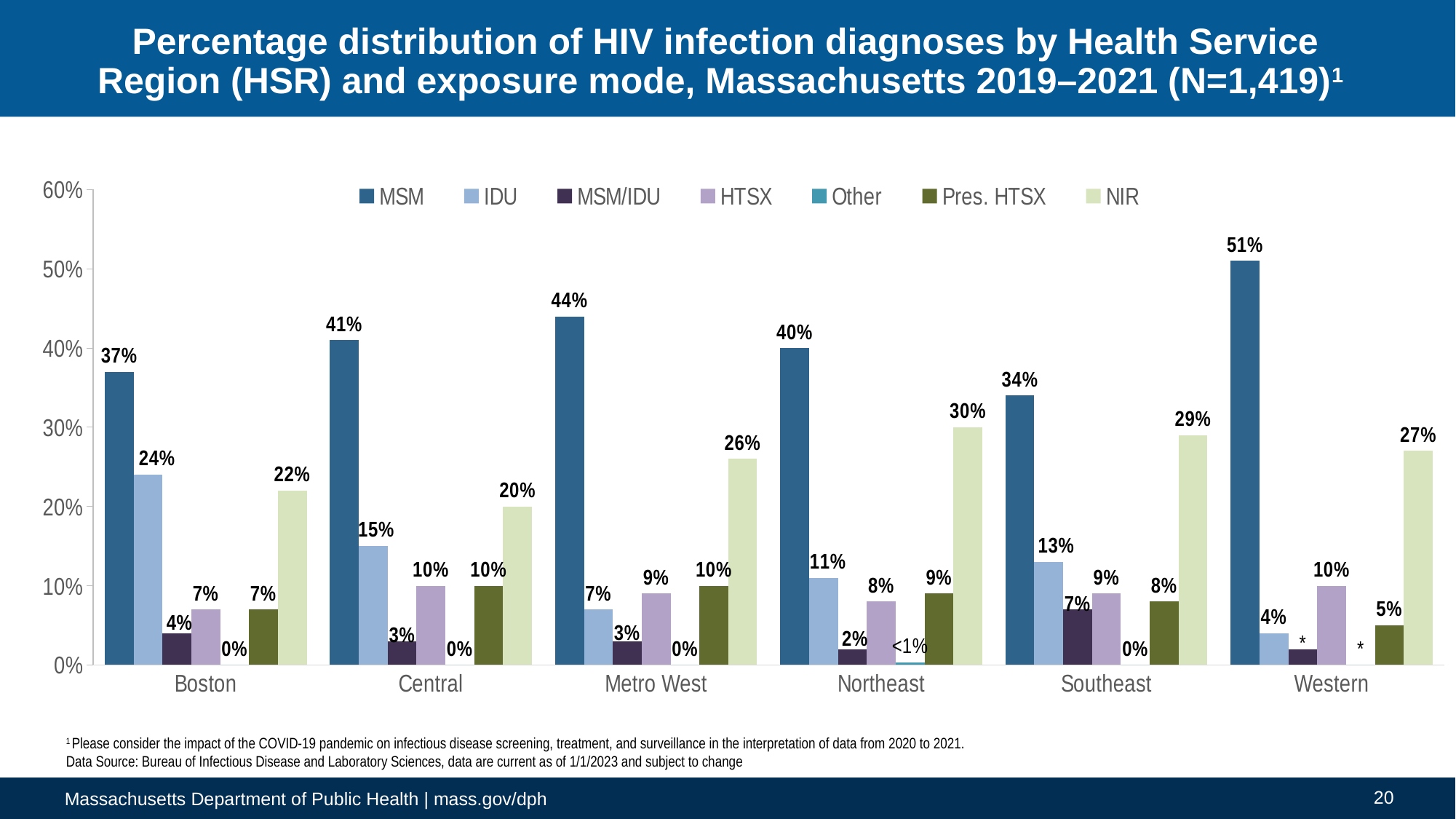
What kind of chart is shown on the slide? Bar chart How many series does the legend list? 7 Which region has the highest MSM percentage? Western What is the Pres. HTSX percentage for Metro West? 10% What is the MSM percentage for the Western region? 51% Which is larger, the IDU percentage in Boston or the IDU percentage in Central? Boston What is the NIR percentage for the Northeast region? 30% Which region has the lowest MSM percentage? Southeast What is the difference between the MSM percentage in Western and the MSM percentage in Boston? 14% How many regions are shown on the x axis? 6 What is the IDU percentage for Boston? 24% Which series is listed last in the legend? NIR